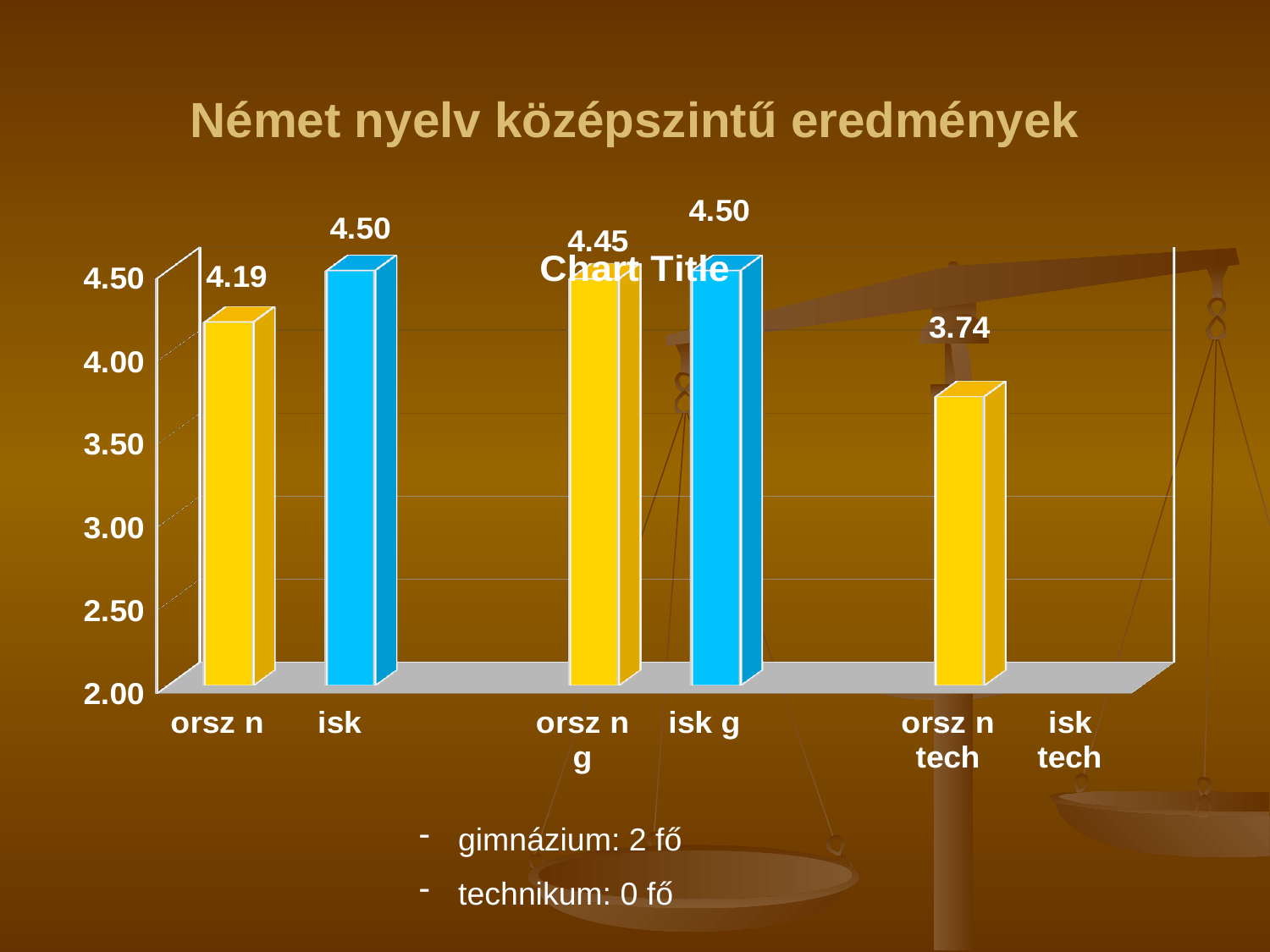
What kind of chart is shown on the slide? bar chart What is the value for "orsz n g"? 4.45 What is the difference between the values for "isk" and "orsz n"? 0.31 What is the value for "isk"? 4.50 What is the difference between the values for "isk g" and "orsz n g"? 0.05 Is the value for "orsz n tech" greater or less than 4.00? less What is the value for "orsz n"? 4.19 Which category has the lowest value among the plotted bars? orsz n tech What is the title of the slide? Német nyelv középszintű eredmények How many category labels are shown on the x axis? 6 Which is larger, the value for "orsz n" or the value for "orsz n tech"? orsz n What is the value for "orsz n tech"? 3.74